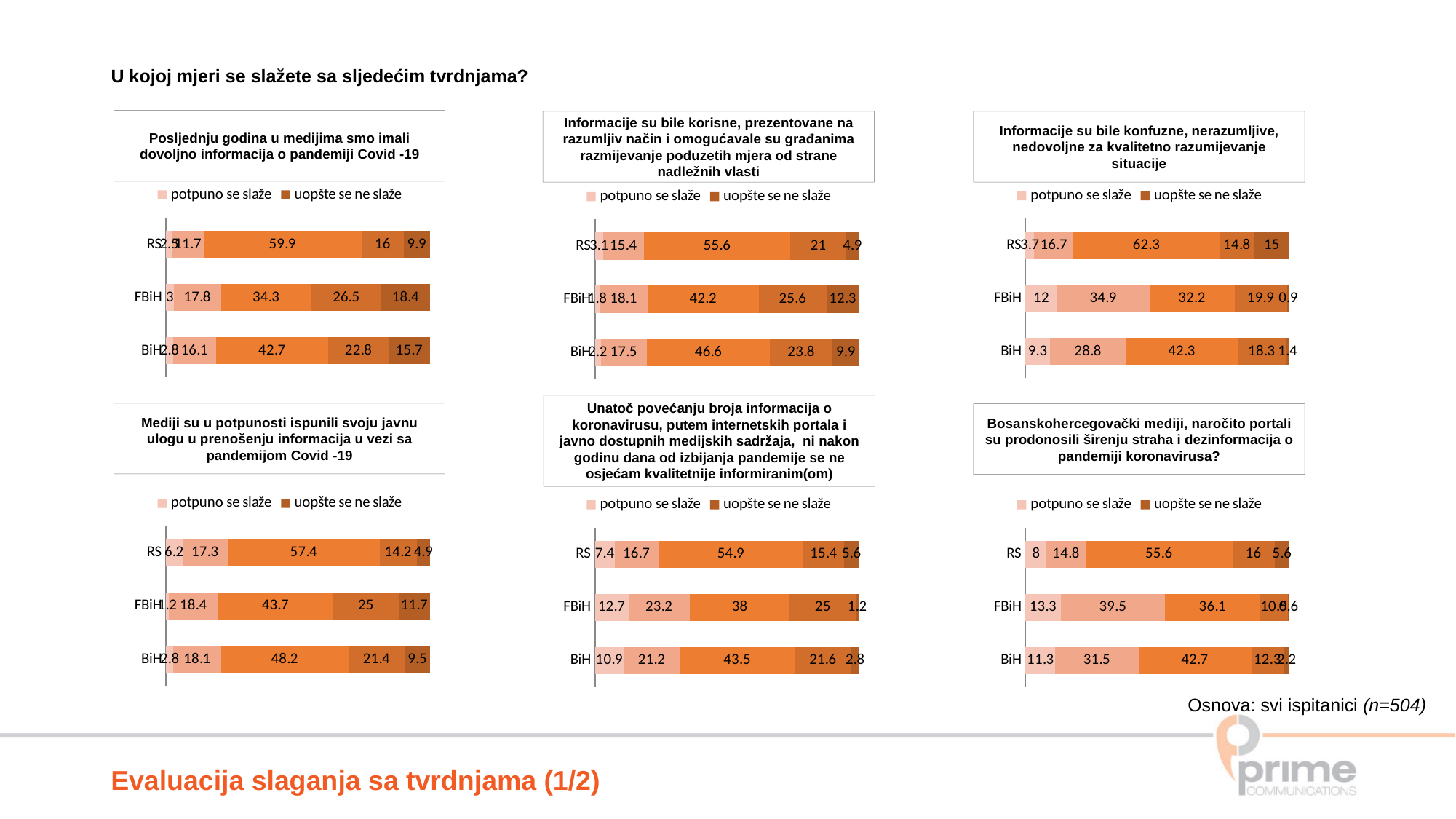
In the bottom-left chart ("Mediji su u potpunosti ispunili svoju javnu ulogu..."), is the "potpuno se slaže" value larger for RS or for FBiH? RS In the top-middle chart ("Informacije su bile korisne..."), what is the difference between the "uopšte se ne slaže" values for FBiH and RS? 7.4 In the top-left chart ("Posljednju godina u medijima smo imali dovoljno informacija o pandemiji Covid -19"), which region has the highest "uopšte se ne slaže" value? FBiH In the top-left chart ("Posljednju godina u medijima smo imali dovoljno informacija o pandemiji Covid -19"), what is the value of "uopšte se ne slaže" for FBiH? 18.4 In the top-middle chart ("Informacije su bile korisne..."), what is the value of "potpuno se slaže" for RS? 3.1 What type of chart is the top-left chart ("Posljednju godina u medijima smo imali dovoljno informacija o pandemiji Covid -19")? Stacked bar chart In the bottom-middle chart ("Unatoč povećanju broja informacija o koronavirusu..."), what is the value of "potpuno se slaže" for BiH? 10.9 In the top-right chart ("Informacije su bile konfuzne..."), which region has the lowest "potpuno se slaže" value? RS In the bottom-left chart ("Mediji su u potpunosti ispunili svoju javnu ulogu..."), what is the value of "uopšte se ne slaže" for BiH? 9.5 In the bottom-right chart ("Bosanskohercegovački mediji, naročito portali..."), what is the value of "uopšte se ne slaže" for RS? 5.6 How many categories (regions) are shown in the bottom-right chart ("Bosanskohercegovački mediji, naročito portali...")? 3 In the top-right chart ("Informacije su bile konfuzne..."), what is the value of "potpuno se slaže" for FBiH? 12